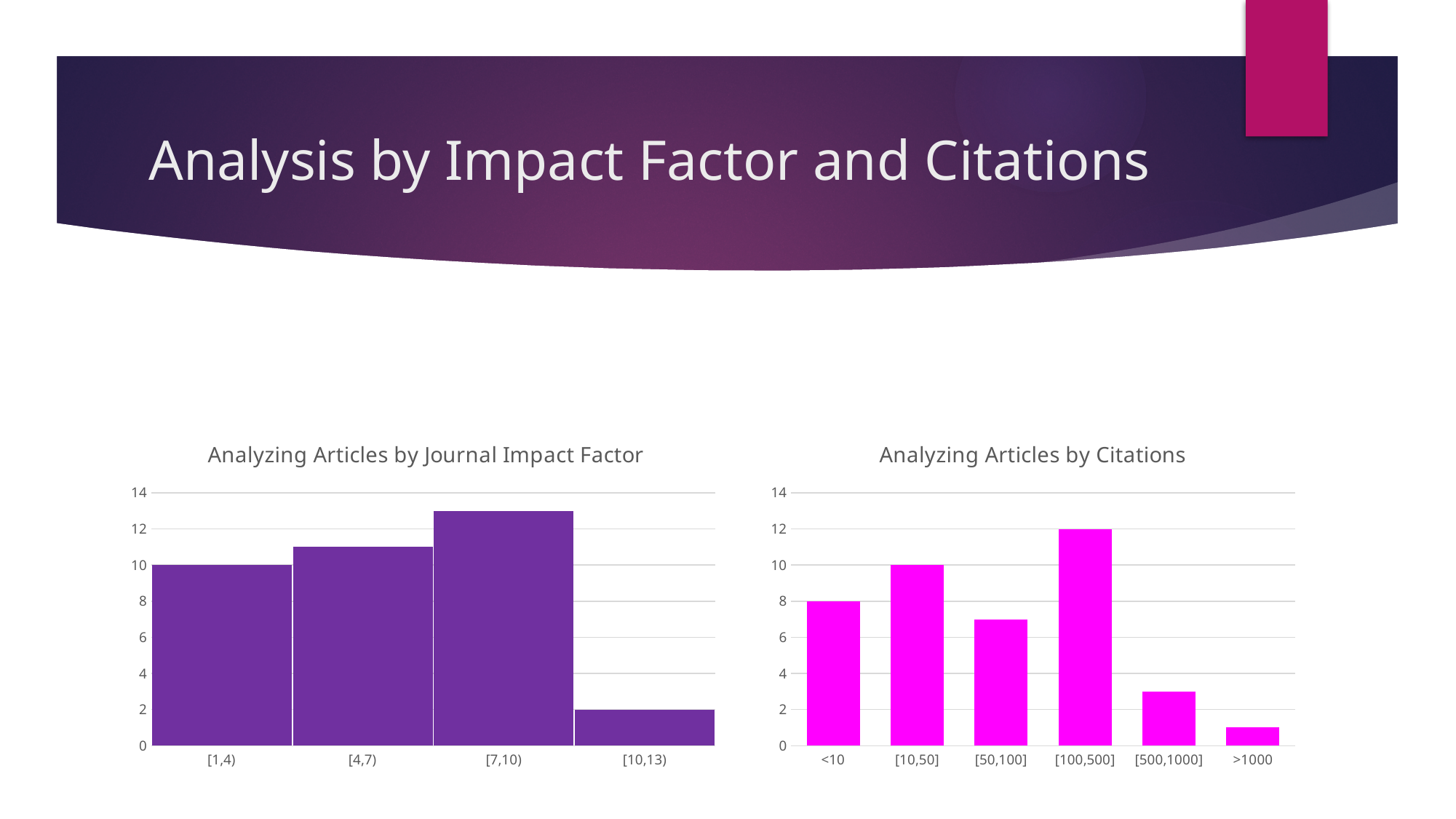
In the 'Analyzing Articles by Journal Impact Factor' chart, how many categories are shown on the x axis? 4 In the 'Analyzing Articles by Citations' chart, is the value for [500,1000] greater or less than 4? less In the 'Analyzing Articles by Journal Impact Factor' chart, is the value for [7,10) greater or less than 12? greater In the 'Analyzing Articles by Journal Impact Factor' chart, what is the value for the [1,4) category? 10 In the 'Analyzing Articles by Journal Impact Factor' chart, what is the value for the [10,13) category? 2 What kind of chart is 'Analyzing Articles by Citations'? bar chart In the 'Analyzing Articles by Citations' chart, which category has the lowest value? >1000 In the 'Analyzing Articles by Citations' chart, what is the difference between the values for [100,500] and <10? 4 In the 'Analyzing Articles by Journal Impact Factor' chart, which category has the lowest value? [10,13) In the 'Analyzing Articles by Citations' chart, what is the value for the [100,500] category? 12 In the 'Analyzing Articles by Citations' chart, what is the value for the <10 category? 8 In the 'Analyzing Articles by Journal Impact Factor' chart, which category has the highest value? [7,10)